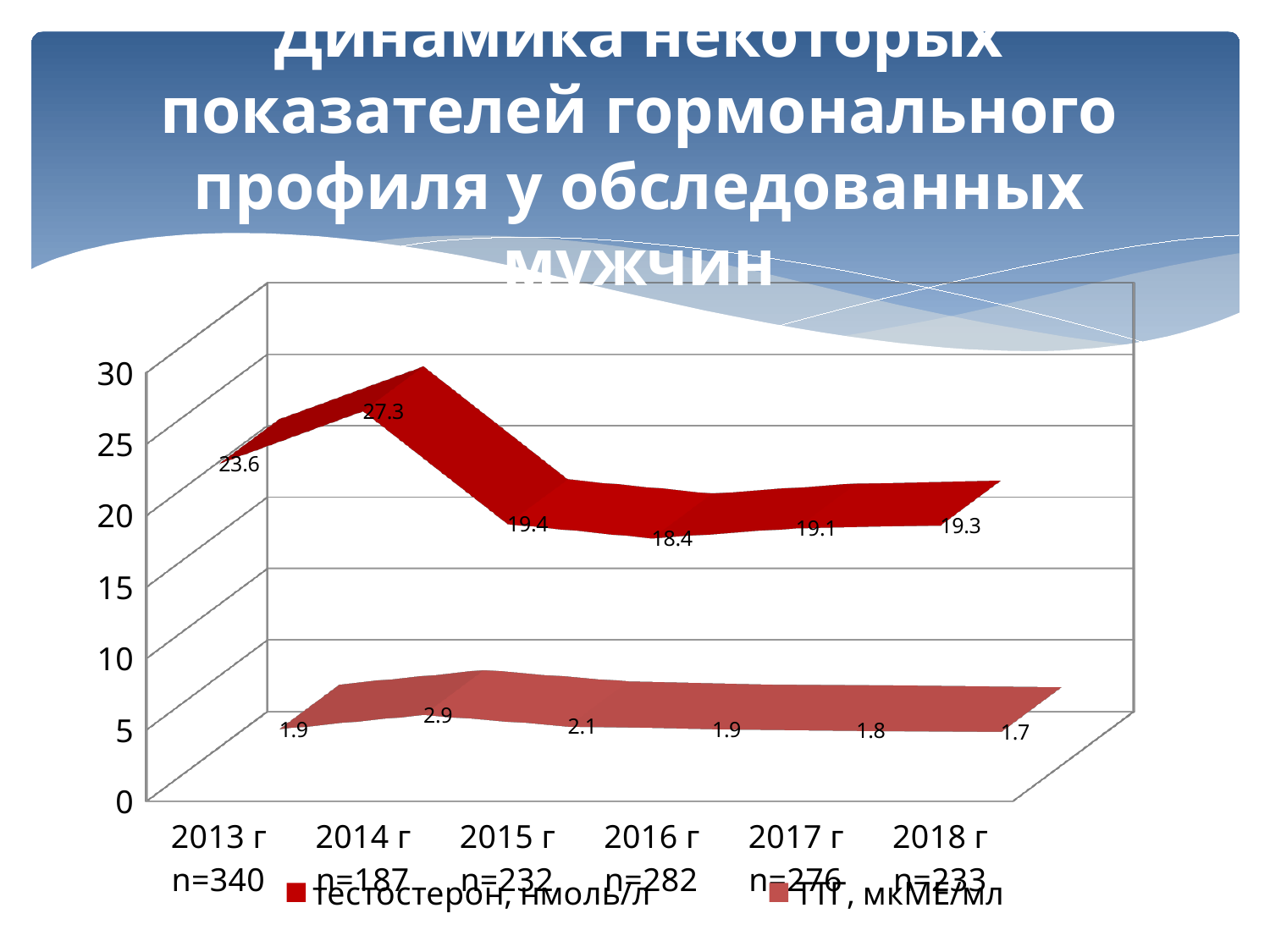
What is the difference between the testosterone values for 2014 г and 2015 г? 7.9 In which year is the testosterone value lowest? 2016 г How many years are shown on the x axis? 6 How many series does the legend list? 2 What is the testosterone value for 2016 г? 18.4 In which year is the ТТГ value highest? 2014 г Does the ТТГ value rise or fall from 2015 г to 2018 г? fall What is the testosterone (Тестостерон, нмоль/л) value for 2014 г? 27.3 What kind of chart is shown on the slide? line chart What is the ТТГ, мкМЕ/мл value for 2018 г? 1.7 In which year is the testosterone value highest? 2014 г Which is larger, the ТТГ value for 2015 г or for 2017 г? 2015 г